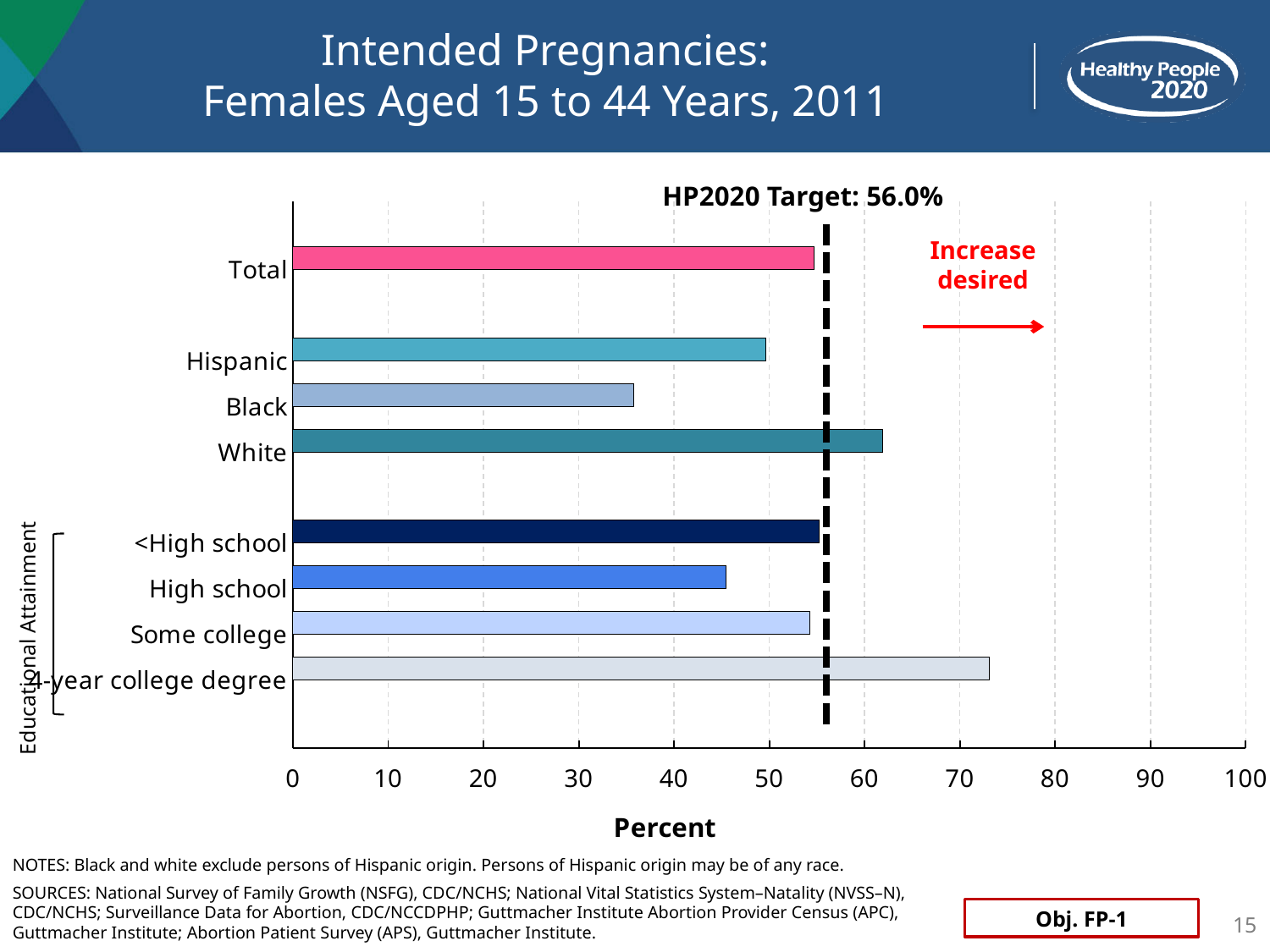
Which category has the lowest percentage of intended pregnancies? Black Which category has the highest percentage of intended pregnancies? 4-year college degree Is the value for High school greater or less than 50? less Which has a higher percentage of intended pregnancies, White or Hispanic? White What is the label of the horizontal axis? Percent Which has a higher percentage of intended pregnancies, 4-year college degree or High school? 4-year college degree What is the HP2020 Target value shown on the chart? 56.0% How many bars (categories) are plotted in the chart? 8 What kind of chart is shown on the slide? bar chart Is the value for 4-year college degree greater or less than 70? greater Is the value for White greater or less than 60? greater